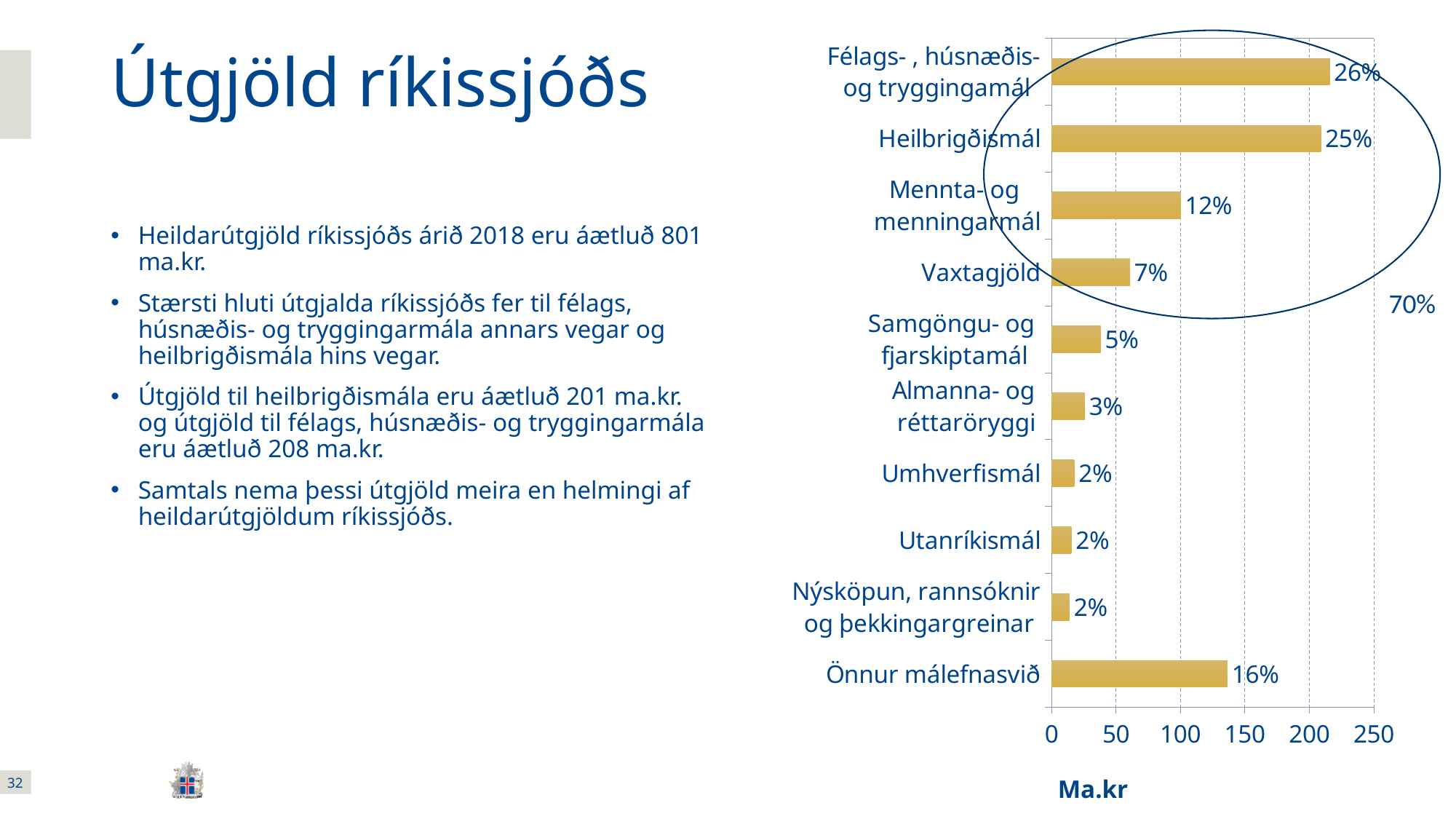
What is the data label shown for Vaxtagjöld? 7% What kind of chart is shown on the slide? bar chart What is the data label shown for Önnur málefnasvið? 16% What unit is shown on the horizontal axis of the chart? Ma.kr Is the value for Vaxtagjöld in Ma.kr greater or less than 50? greater What is the data label shown for Mennta- og menningarmál? 12% What is the data label shown for Heilbrigðismál? 25% Which is larger, the value for Önnur málefnasvið or the value for Mennta- og menningarmál? Önnur málefnasvið Which category has the highest value in the chart? Félags- , húsnæðis- og tryggingamál Is the value for Önnur málefnasvið in Ma.kr greater or less than 150? less How many categories are plotted in the chart? 10 What is the difference in percentage points between the labels for Félags- , húsnæðis- og tryggingamál and Mennta- og menningarmál? 14 percentage points